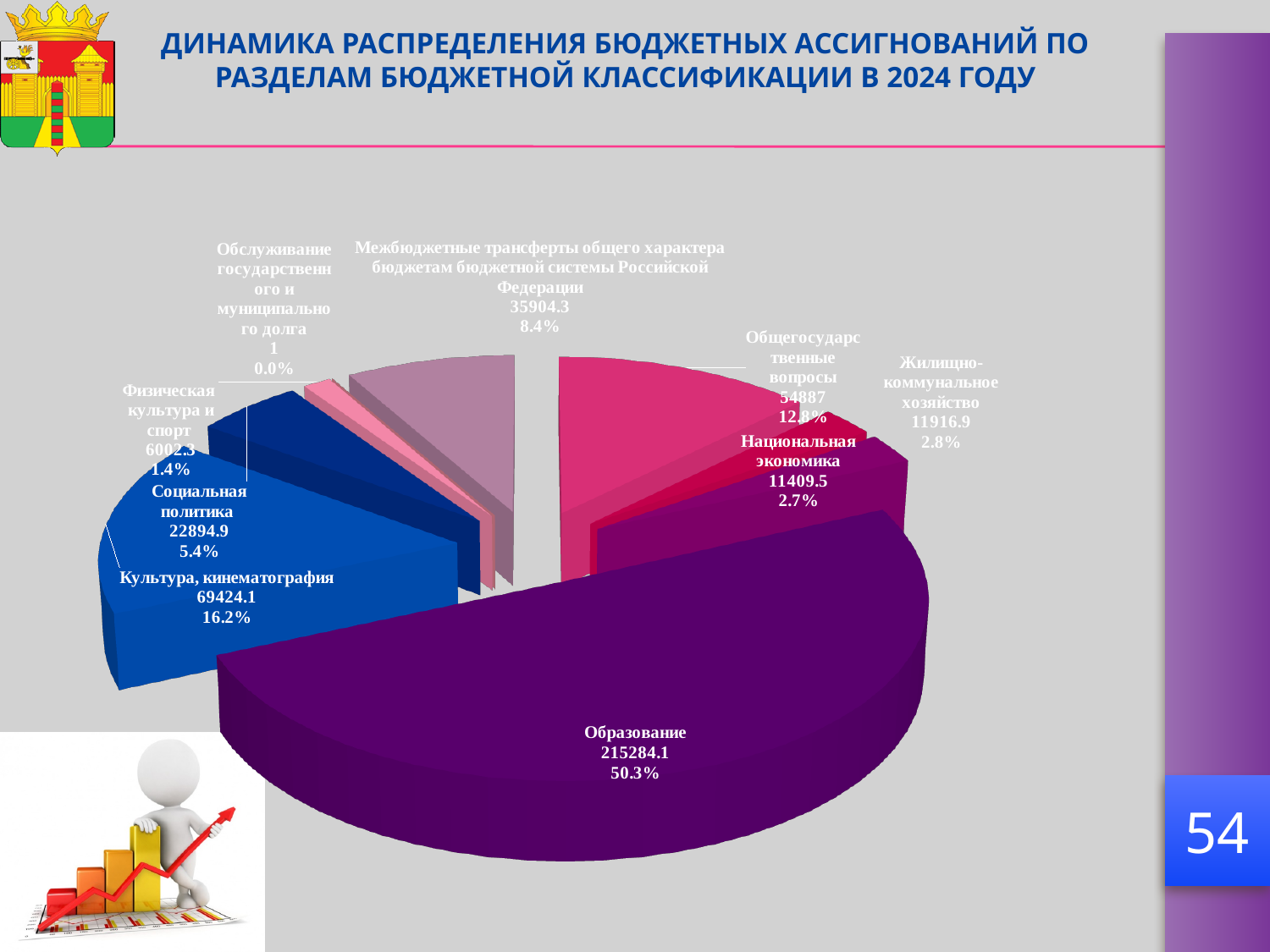
What percentage is shown for Социальная политика? 5.4% Which category has the largest share of the pie? Образование What share of the pie does Культура, кинематография represent? 16.2% What is the value shown for Общегосударственные вопросы? 54887 Which category has the smallest share of the pie? Обслуживание государственного и муниципального долга What is the difference between the values for Образование and Культура, кинематография? 145860 How many categories are shown in the pie chart? 9 What is the difference between the values for Социальная политика and Физическая культура и спорт? 16892.6 What type of chart is shown on the slide? pie chart Which is larger: the value for Жилищно-коммунальное хозяйство or the value for Национальная экономика? Жилищно-коммунальное хозяйство What year does the chart title refer to? 2024 What is the value shown for Образование? 215284.1